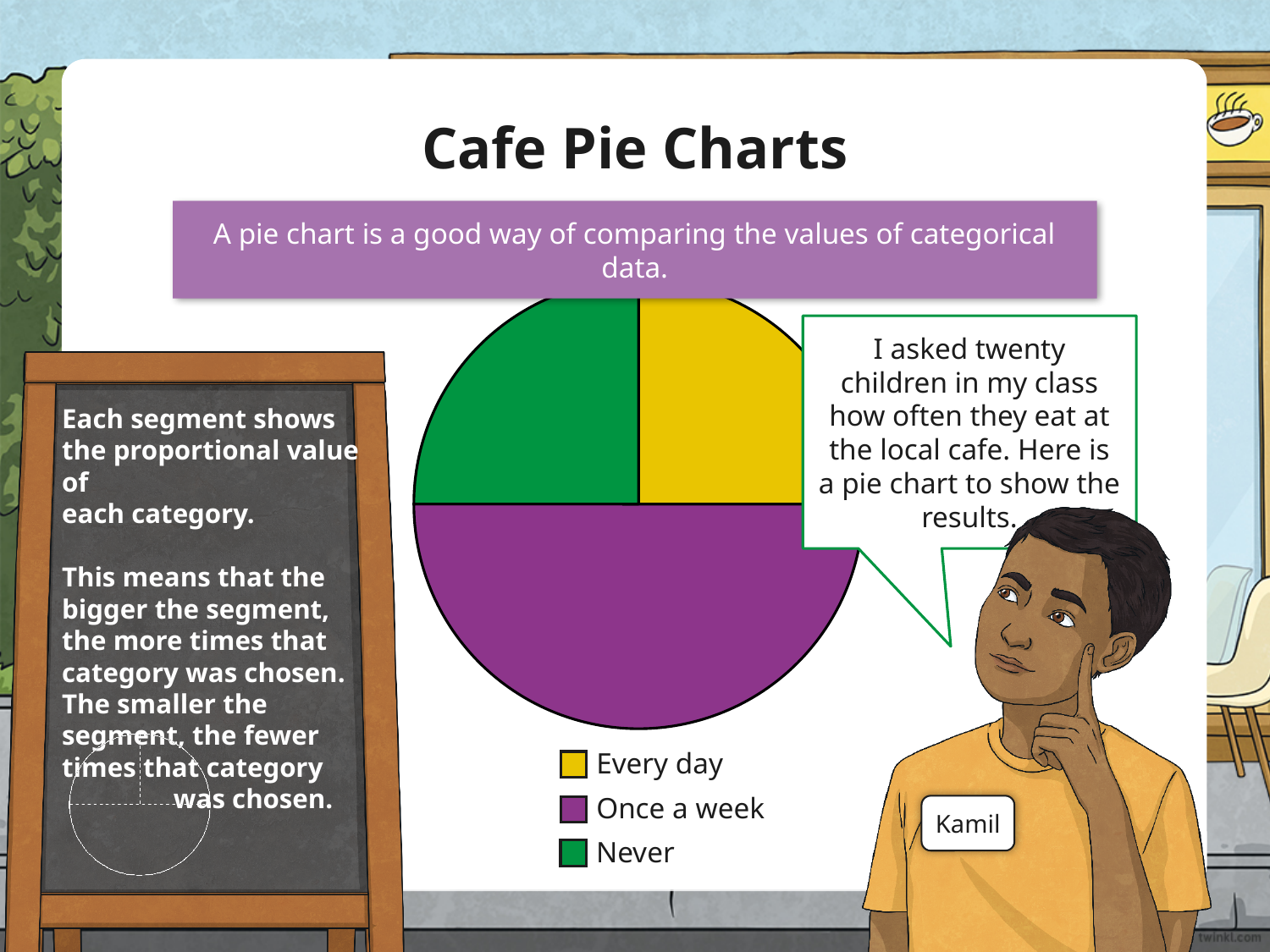
Which category has the largest slice of the pie chart? Once a week Which is larger, the slice for Once a week or the slice for Every day? Once a week Which category is shown in yellow in the pie chart? Every day Which is larger, the slice for Never or the slice for Once a week? Once a week How many categories does the pie chart show? 3 How many entries does the legend list? 3 What colour is the slice for Never in the pie chart? green What kind of chart is shown on the slide? pie chart